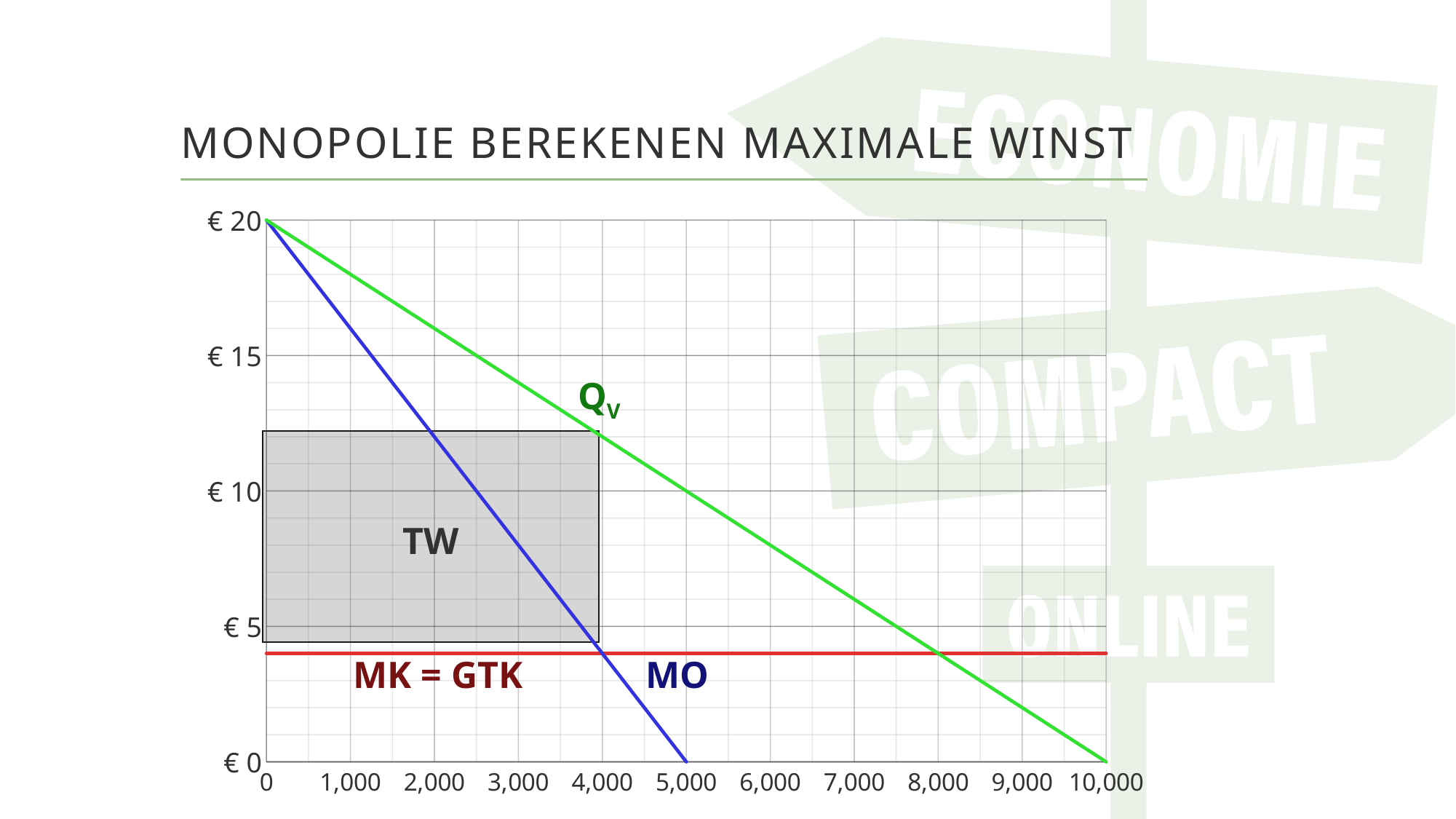
At what quantity does the MO line reach € 0? 5,000 What label is written inside the shaded rectangle on the chart? TW At a quantity of 0, what price does the Qv line start at? € 20 Does the MO line rise or fall as quantity increases along the x axis? fall What is the title of the slide? MONOPOLIE BEREKENEN MAXIMALE WINST At a quantity of 2,000, which line has the higher value, Qv or MO? Qv What is the difference between the quantity where Qv reaches € 0 and the quantity where MO reaches € 0? 5,000 Is the value of the MK = GTK line greater or less than € 5? less How many labelled lines are plotted on the chart? 3 What kind of chart is shown on the slide? line chart At a quantity of 4,000, is the value of the Qv line greater or less than € 10? greater At what quantity does the Qv line reach € 0? 10,000